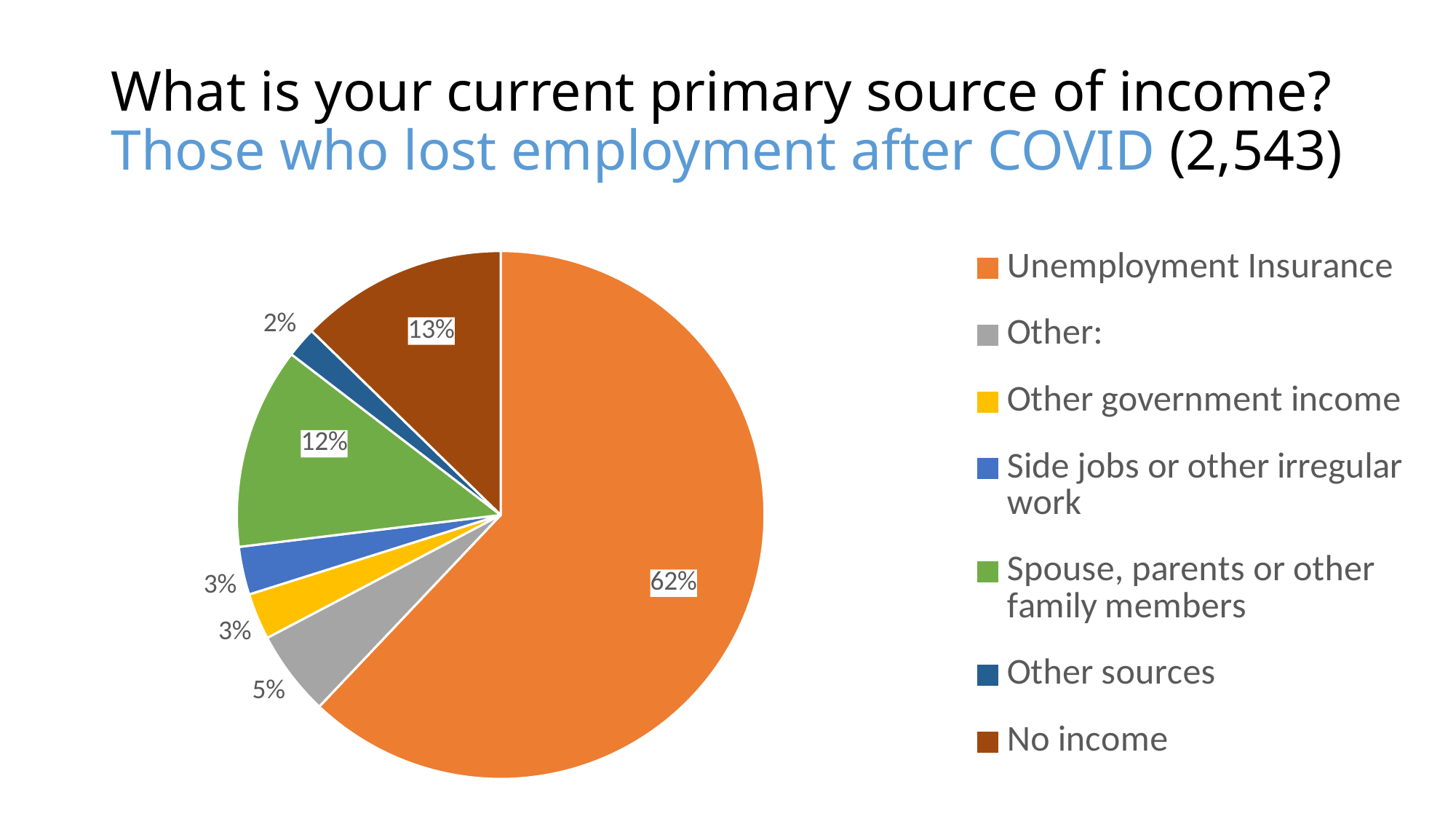
What type of chart is shown on the slide? Pie chart What share of the pie is Unemployment Insurance? 62% Which category has the smallest share of the pie? Other sources What is the value for Spouse, parents or other family members? 12% How many categories does the pie chart show? 7 What colour is the Unemployment Insurance slice? Orange What is the difference between the No income share and the Spouse, parents or other family members share? 1% What is the value for the Other: category? 5% Which is larger, the share for Other: or the share for Other government income? Other: What percentage of respondents reported No income as their primary source? 13% Which category has the largest share of the pie? Unemployment Insurance What is the value for Other sources? 2%